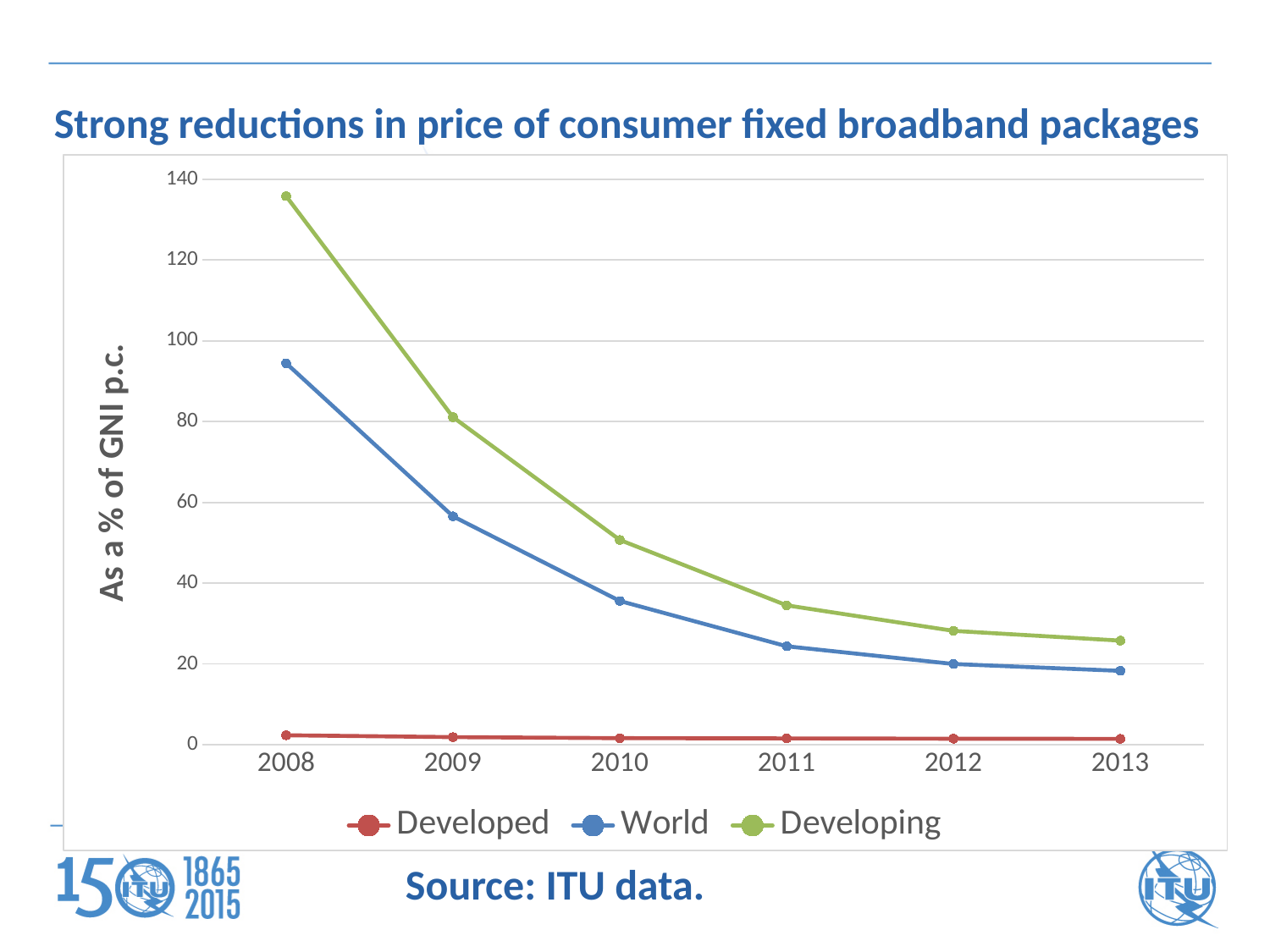
Is the value for Developing in 2013 greater or less than 20? greater What is the label on the vertical axis? As a % of GNI p.c. How many series does the legend list? 3 Does the Developing series rise or fall from 2008 to 2013? fall Is the value for Developing in 2008 greater or less than 120? greater Which is larger in 2010, the value for World or the value for Developing? Developing What kind of chart is shown on the slide? line chart Is the value for World in 2012 greater or less than 40? less How many years are plotted along the x axis? 6 Which series has the lowest value in 2013? Developed Which series has the highest value in 2008? Developing